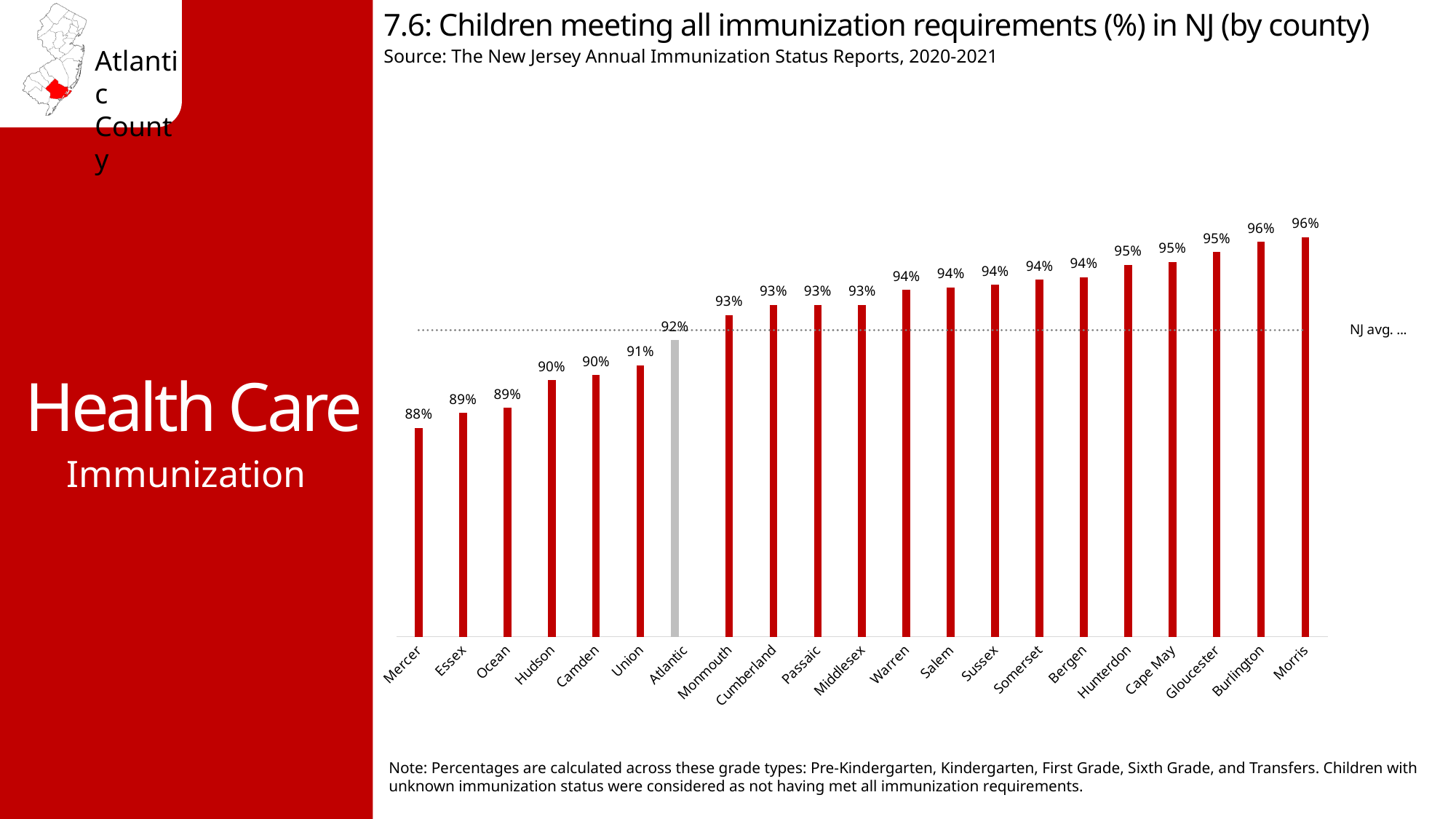
How many counties are shown on the chart? 21 What kind of chart is shown on the slide? Bar chart What is the value for Hunterdon County? 95% What is the difference between the values for Morris and Mercer? 8% What is the difference between the values for Atlantic and Union? 1% Which county has the lowest percentage of children meeting all immunization requirements? Mercer What is the value for Atlantic County? 92% Which has a higher value, Camden or Warren? Warren What is the value for Morris County? 96% What is the value for Mercer County? 88% Do the values rise or fall moving from left to right along the x axis? Rise Which county's bar is coloured grey instead of red? Atlantic